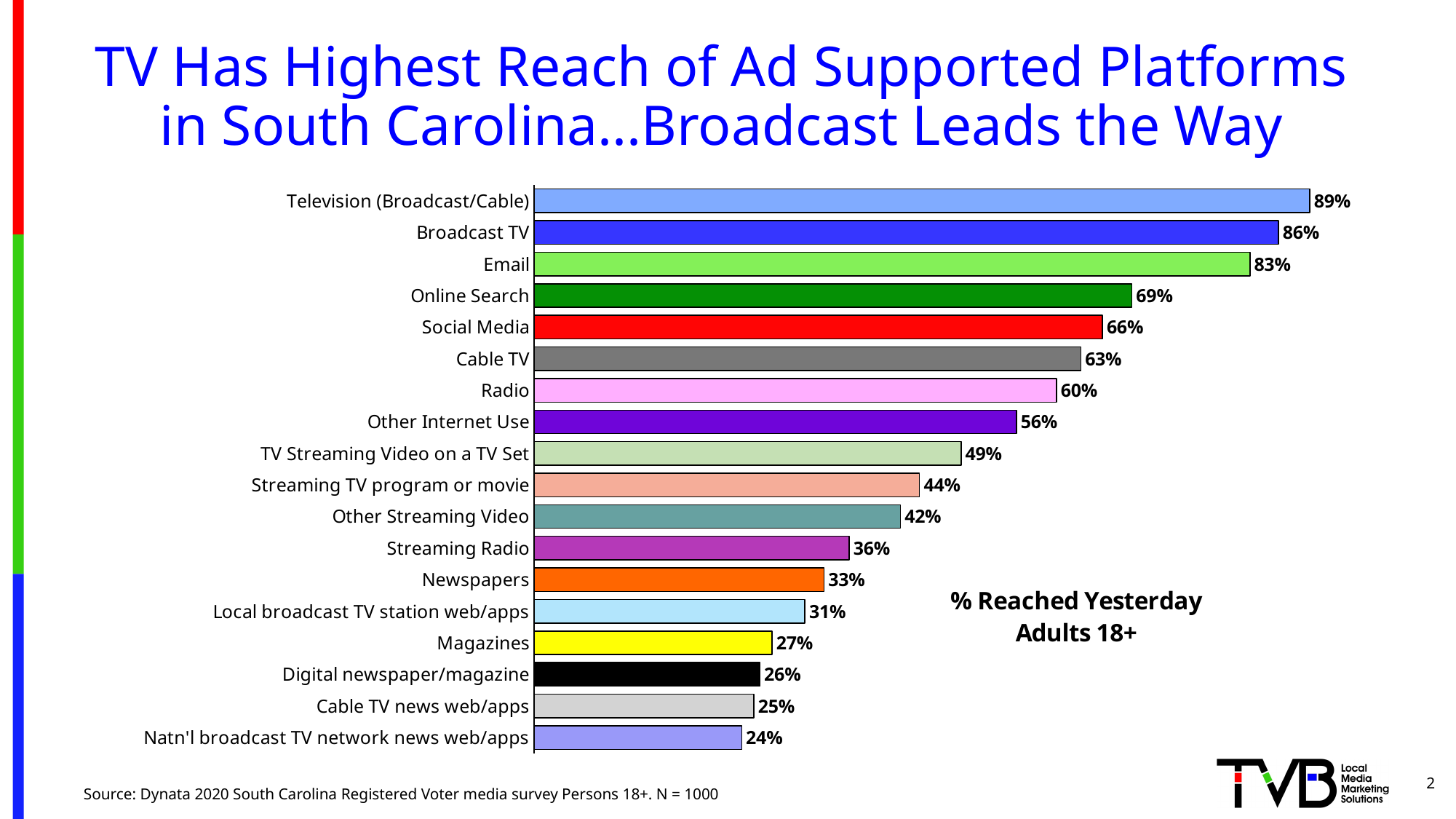
What is the difference between the values for Magazines and Digital newspaper/magazine? 1% Which category has the lowest value? Natn'l broadcast TV network news web/apps What is the difference between the values for Email and Online Search? 14% How many categories are shown in the chart? 18 Which is larger, the value for Cable TV or the value for Social Media? Social Media What is the value for TV Streaming Video on a TV Set? 49% Which category has the highest value? Television (Broadcast/Cable) What is the value for Broadcast TV? 86% What is the value for Newspapers? 33% What kind of chart is shown on the slide? Bar chart What is the value for Radio? 60% What measure does the chart's label say the values represent? % Reached Yesterday Adults 18+